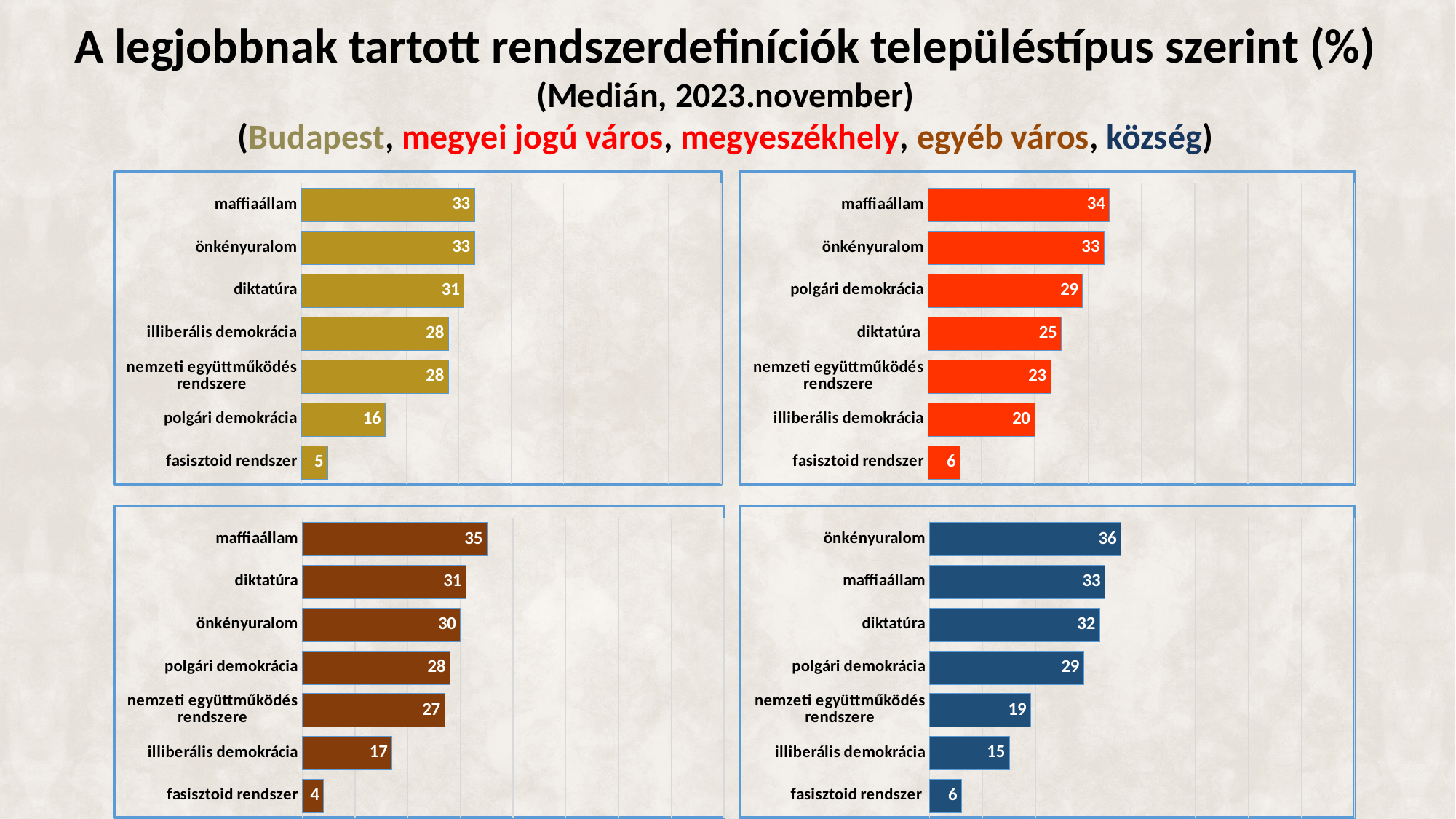
How many categories are shown in the top-left chart? 7 How many charts are shown on the slide? 4 In the top-left chart, what is the difference between the values for maffiaállam and polgári demokrácia? 17 In the top-left chart, what is the value for diktatúra? 31 In the bottom-left chart, what is the value for illiberális demokrácia? 17 What type of chart is the bottom-left chart? bar chart In the top-right chart, what is the value for polgári demokrácia? 29 In the bottom-right chart, which category has the highest value? önkényuralom In the bottom-right chart, what is the value for nemzeti együttműködés rendszere? 19 In the top-right chart, what is the difference between the values for maffiaállam and fasisztoid rendszer? 28 In the bottom-left chart, which category has the lowest value? fasisztoid rendszer In the bottom-right chart, which is larger: the value for diktatúra or the value for polgári demokrácia? diktatúra